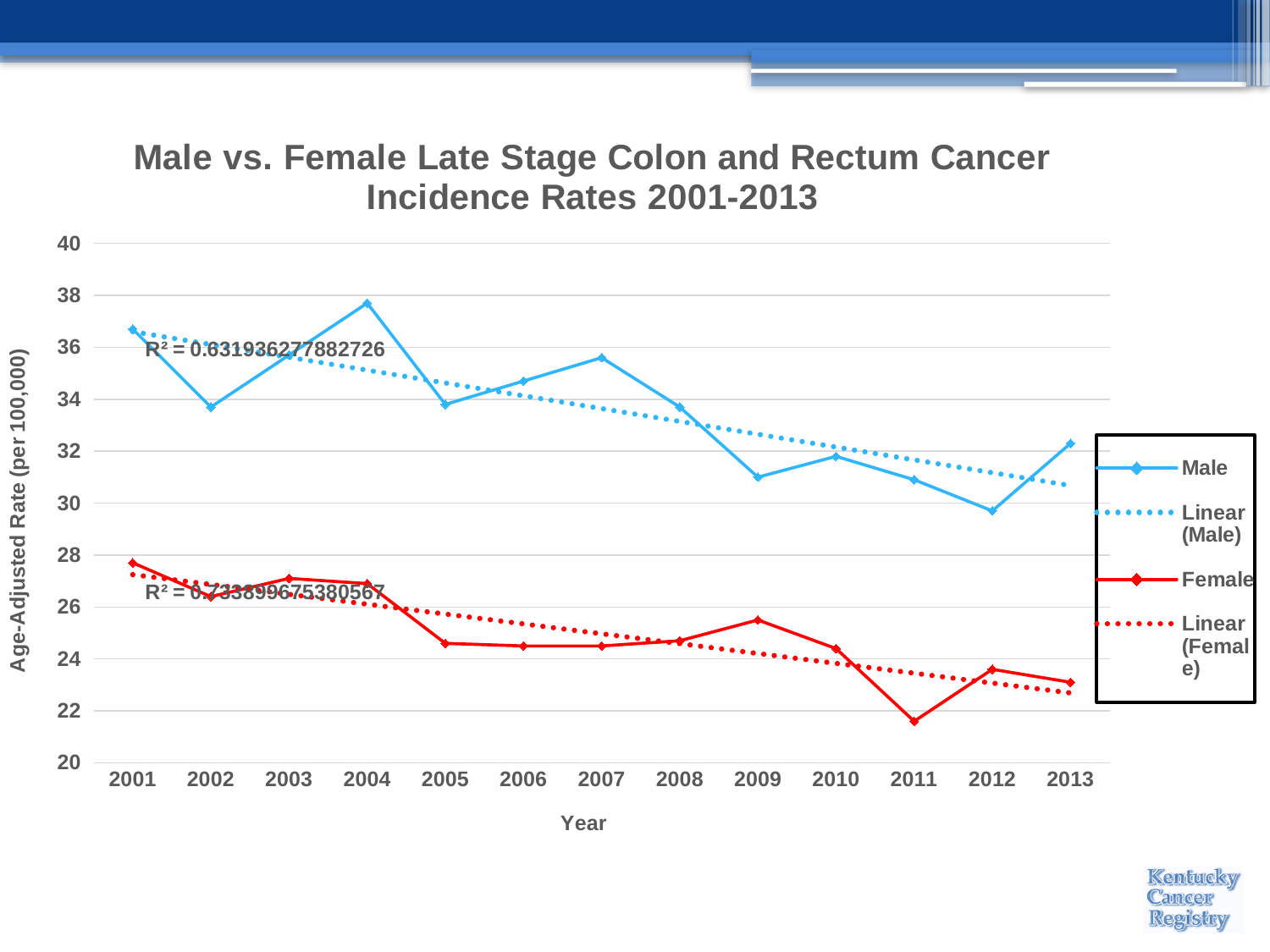
Overall, do the Male and Female rates rise or fall from 2001 to 2013? fall How many series does the legend list? 4 Is the Female value for 2011 greater or less than 22? less What kind of chart is shown on the slide? line chart In which year is the Male late stage incidence rate highest? 2004 In which year is the Male late stage incidence rate lowest? 2012 In which year is the Female late stage incidence rate highest? 2001 Which is larger, the Female value for 2009 or the Female value for 2011? 2009 What R² value is shown for the Male linear trendline? R² = 0.631936277882726 How many years are plotted along the x axis? 13 Is the Male value for 2004 greater or less than 36? greater In which year is the Female late stage incidence rate lowest? 2011